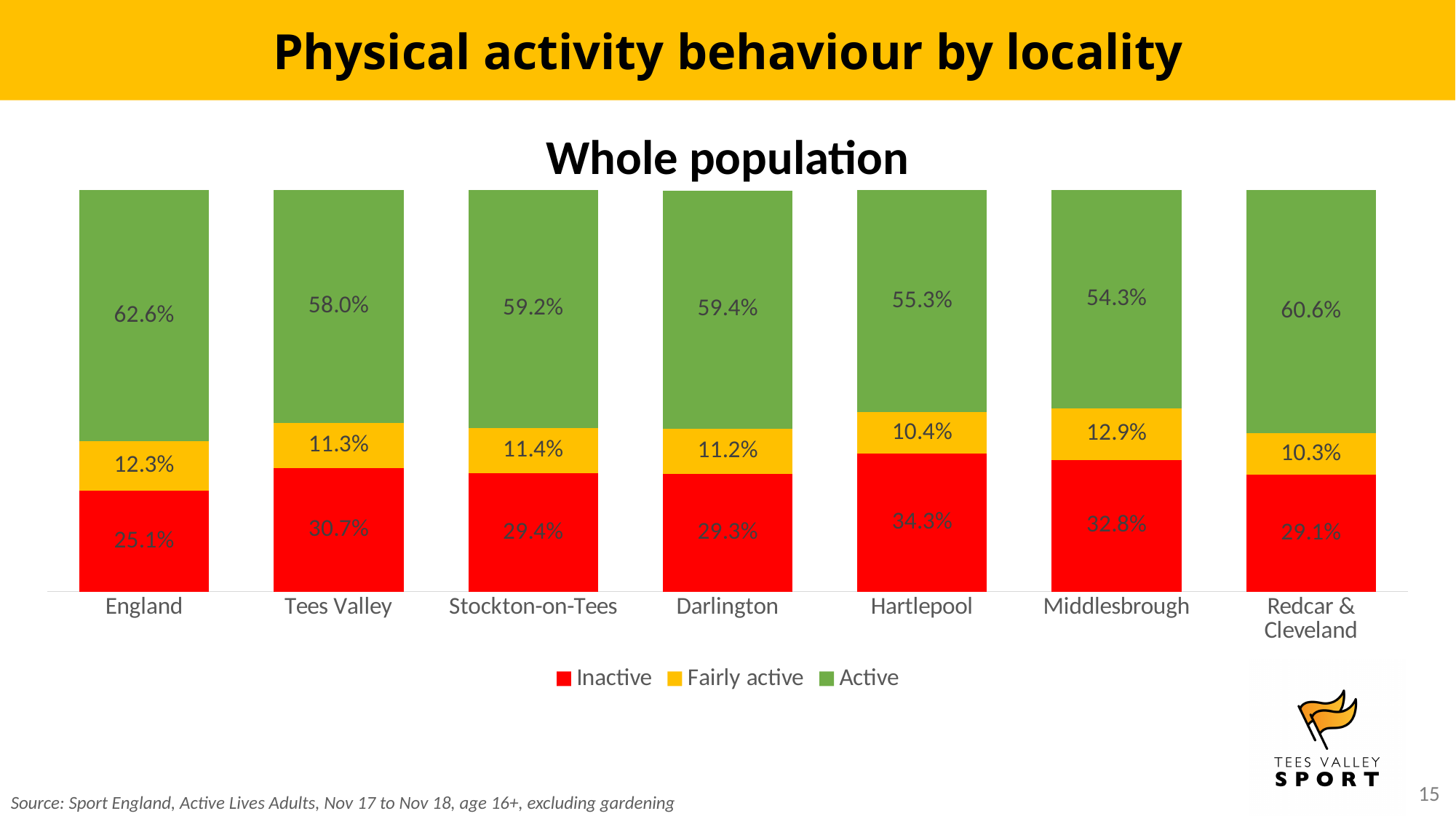
What is the Active value for Redcar & Cleveland? 60.6% Which locality has the lowest Active value? Middlesbrough Which locality has the highest Inactive value? Hartlepool What is the total of the stacked bar for Tees Valley? 100.0% What is the difference between the Inactive value for Hartlepool and the Inactive value for England? 9.2 percentage points Which locality has the highest Fairly active value? Middlesbrough How many series does the legend list? 3 Which is larger, the Inactive value for Middlesbrough or the Inactive value for Tees Valley? Middlesbrough How many localities are shown on the x axis? 7 What kind of chart is shown? Stacked bar chart What is the Fairly active value for Darlington? 11.2% What is the Inactive value for Hartlepool? 34.3%